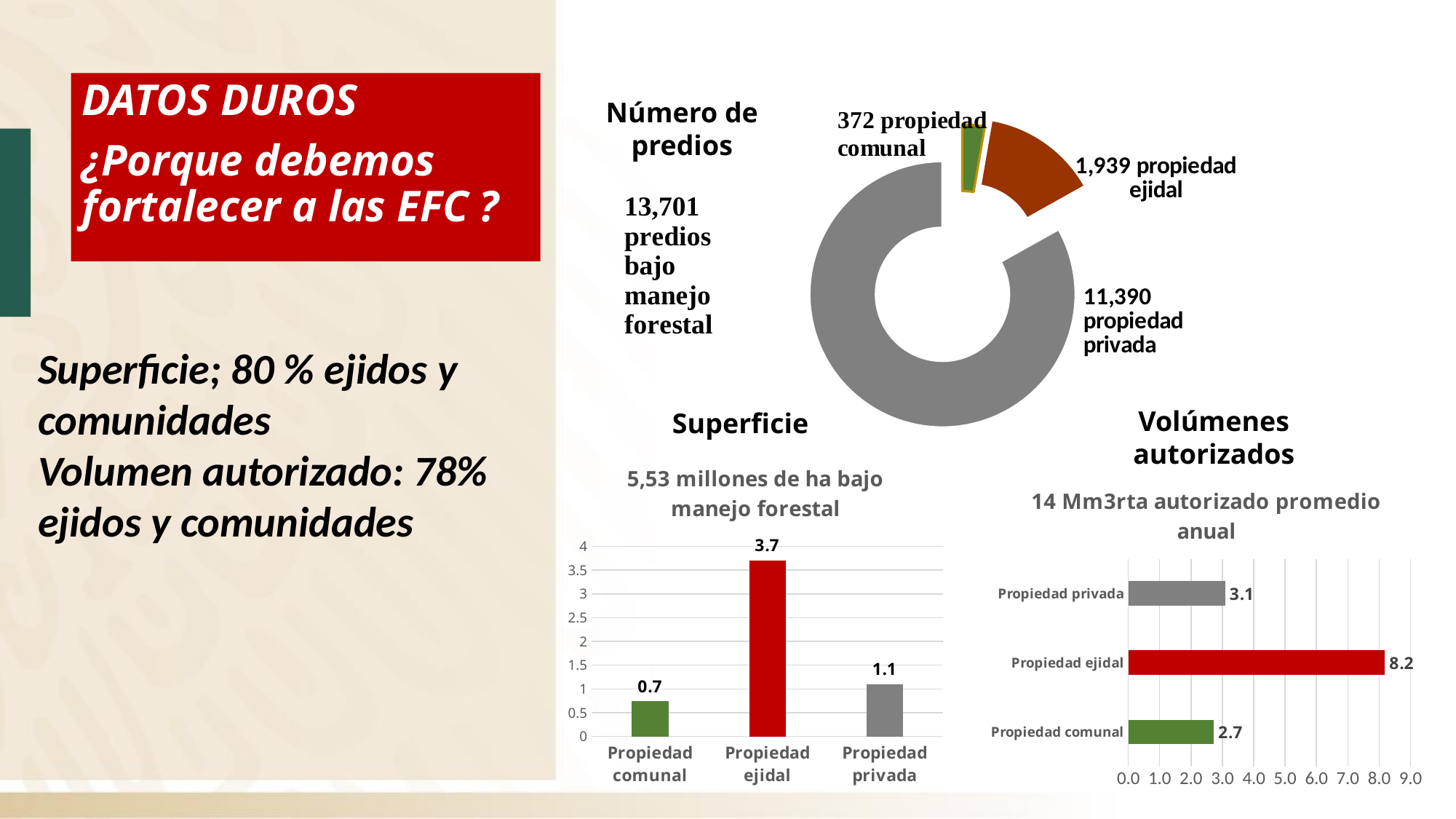
In the 'Número de predios' donut chart, how many predios are propiedad ejidal? 1,939 In the 'Superficie' bar chart, what is the value for Propiedad comunal? 0.7 In the 'Número de predios' donut chart, which category has the smallest number of predios? propiedad comunal What type of chart is the 'Número de predios' chart? Donut (pie) chart In the 'Superficie' bar chart, which category has the highest value? Propiedad ejidal How many categories are shown in the 'Volúmenes autorizados' bar chart? 3 In the 'Número de predios' donut chart, how many predios are propiedad privada? 11,390 In the 'Volúmenes autorizados' bar chart, what is the value for Propiedad ejidal? 8.2 In the 'Superficie' bar chart, what is the value for Propiedad ejidal? 3.7 In the 'Número de predios' donut chart, what is the difference between propiedad privada and propiedad ejidal predios? 9,451 In the 'Superficie' bar chart, what is the difference between Propiedad ejidal and Propiedad privada? 2.6 In the 'Volúmenes autorizados' bar chart, which is larger, Propiedad privada or Propiedad comunal? Propiedad privada